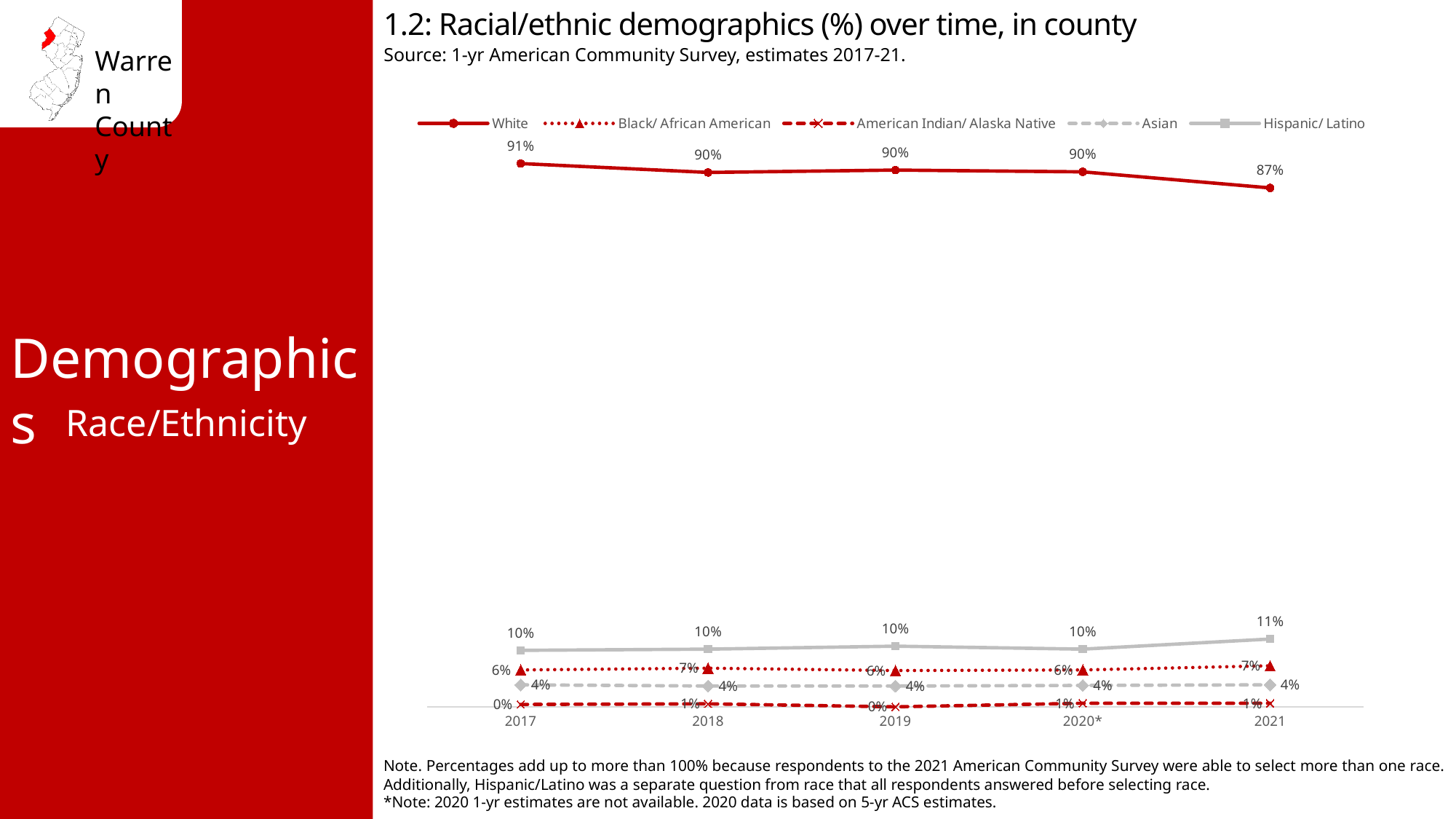
In which year is the White value lowest? 2021 Which series has the highest value in 2021? White What is the value for Hispanic/ Latino in 2021? 11% What is the value for White in 2017? 91% What is the value for White in 2021? 87% What type of chart is shown on the slide? line chart How many series does the legend list? 5 What is the value for Black/ African American in 2018? 7% What is the difference between the White value in 2017 and in 2021? 4% What is the value for Asian in 2019? 4% Does the White series rise or fall from 2017 to 2021? fall How many years are shown on the x axis? 5